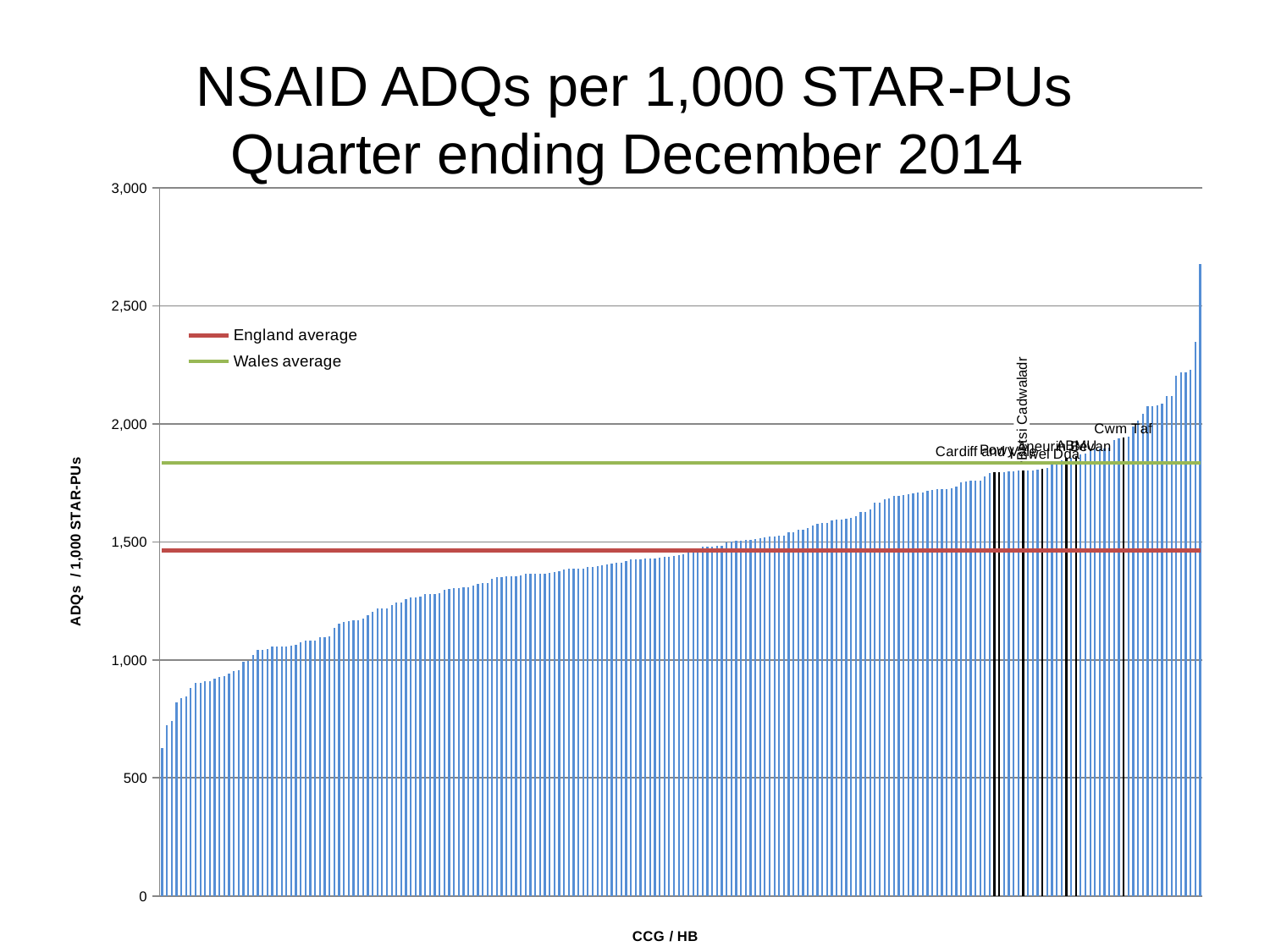
Which is higher, the Wales average or the England average? Wales average Which is higher, the value for Cwm Taf or the England average? Cwm Taf What kind of chart is shown on the slide? Bar chart Is the Wales average line greater or less than 1,500? greater How many entries does the chart legend list? 2 Is the value for Cwm Taf greater or less than 1,500? greater Is the England average line greater or less than 1,500? less What is the title of the chart? NSAID ADQs per 1,000 STAR-PUs Quarter ending December 2014 Do the bar values rise or fall from left to right along the x axis? Rise What is the label of the vertical axis? ADQs / 1,000 STAR-PUs